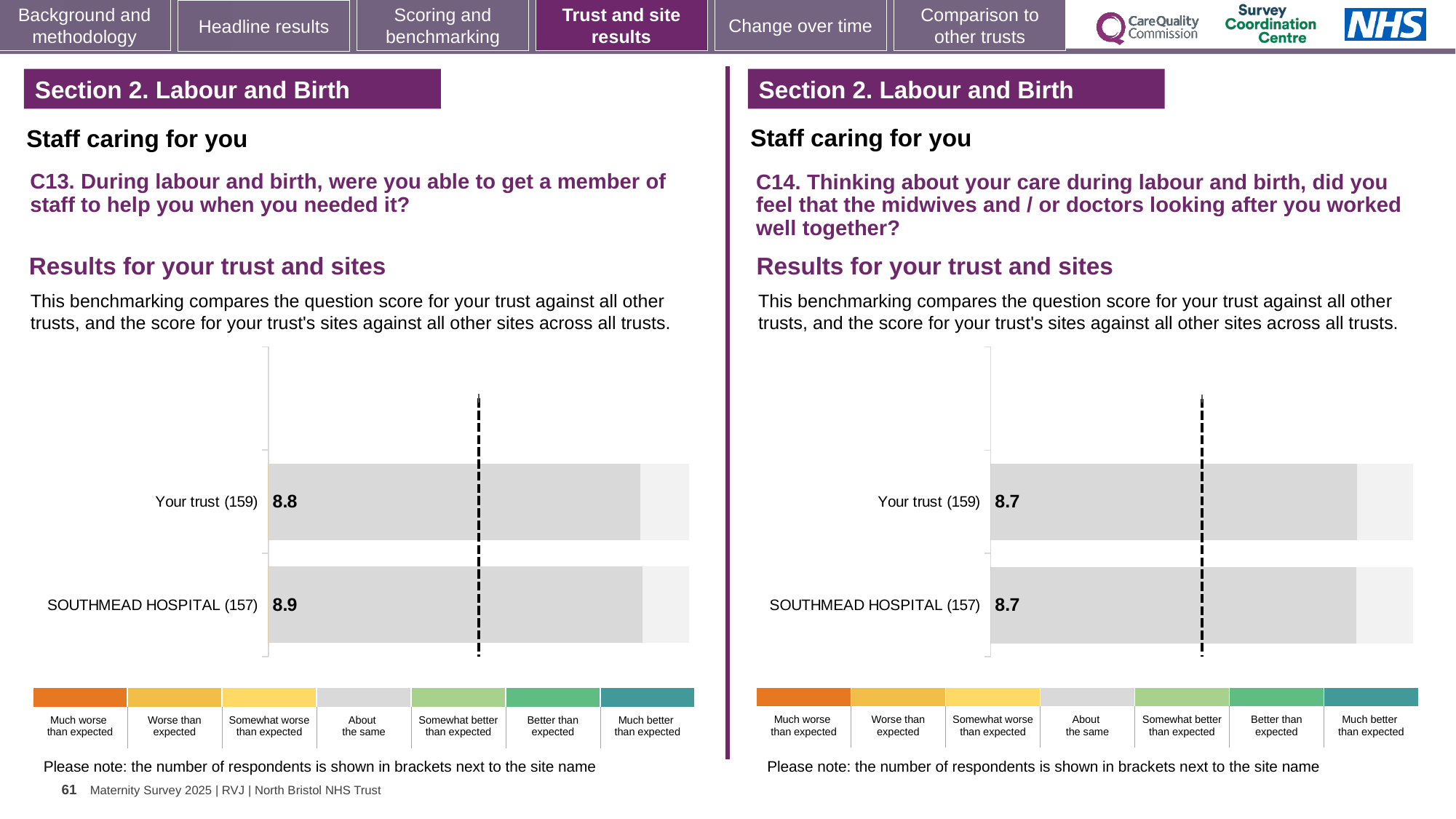
In the C13 chart on the left, which has the higher score, Your trust or SOUTHMEAD HOSPITAL? SOUTHMEAD HOSPITAL In the C14 chart on the right, what is the score for Your trust (159)? 8.7 How many bars are plotted in the C13 chart on the left? 2 What type of chart is used for the C13 results on the left? Bar chart In the C14 chart on the right, what is the score for SOUTHMEAD HOSPITAL (157)? 8.7 In the C13 chart on the left, what is the difference between the SOUTHMEAD HOSPITAL score and the Your trust score? 0.1 How many categories does the colour legend below the C14 chart on the right list? 7 In the C13 chart on the left, what is the score for SOUTHMEAD HOSPITAL (157)? 8.9 In the C13 chart on the left, what is the score for Your trust (159)? 8.8 In the C14 chart on the right, what is the difference between the Your trust score and the SOUTHMEAD HOSPITAL score? 0 In the C13 chart on the left, how many respondents are shown in brackets for SOUTHMEAD HOSPITAL? 157 How many bars are plotted in the C14 chart on the right? 2